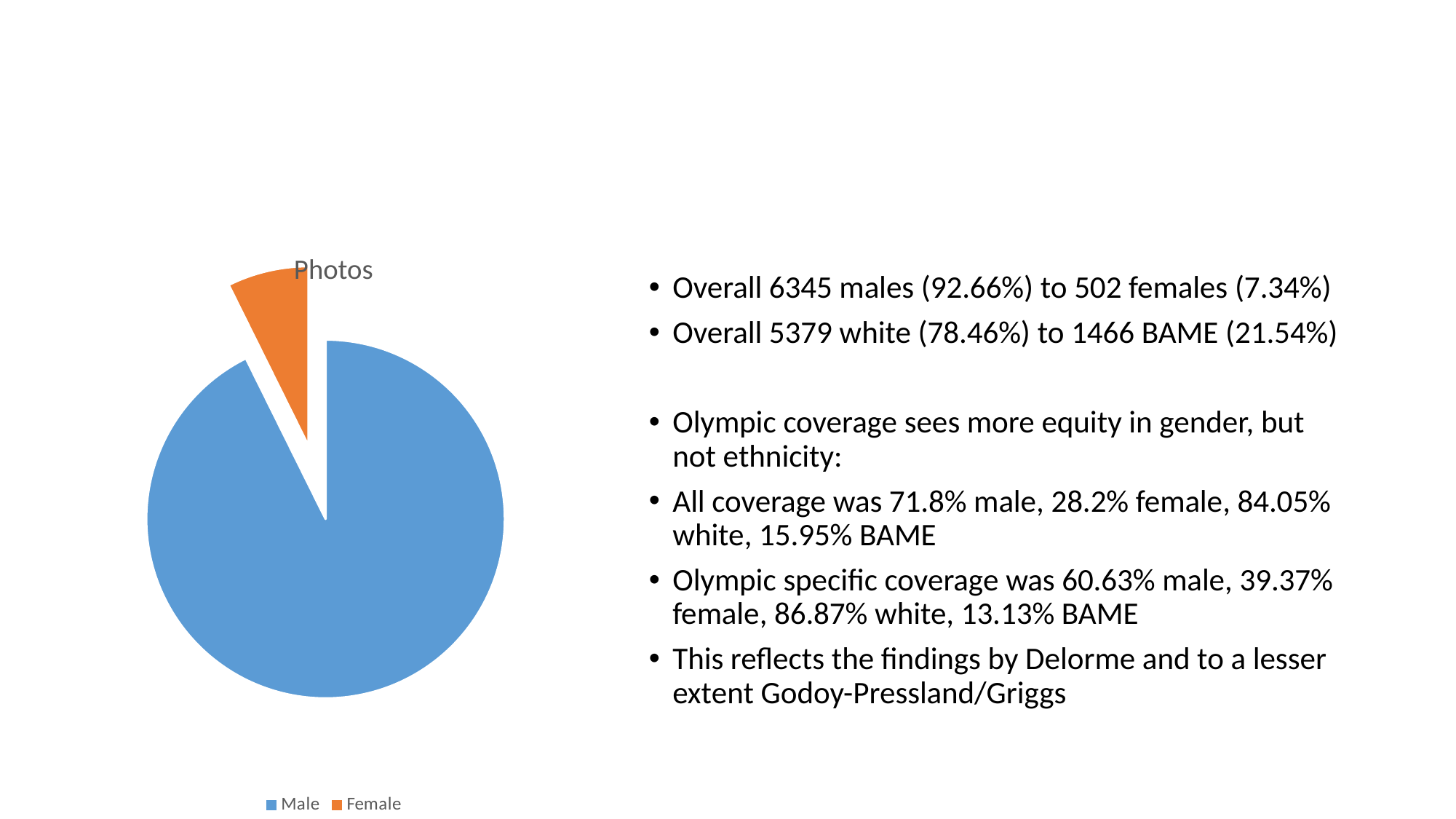
What colour represents Female in the pie chart? orange Which slice is larger, Male or Female? Male Which category has the smallest slice of the pie chart? Female Which category has the largest slice of the pie chart? Male What kind of chart is shown on the slide? pie chart How many entries does the chart legend list? 2 What is the title of the chart? Photos How many slices does the pie chart have? 2